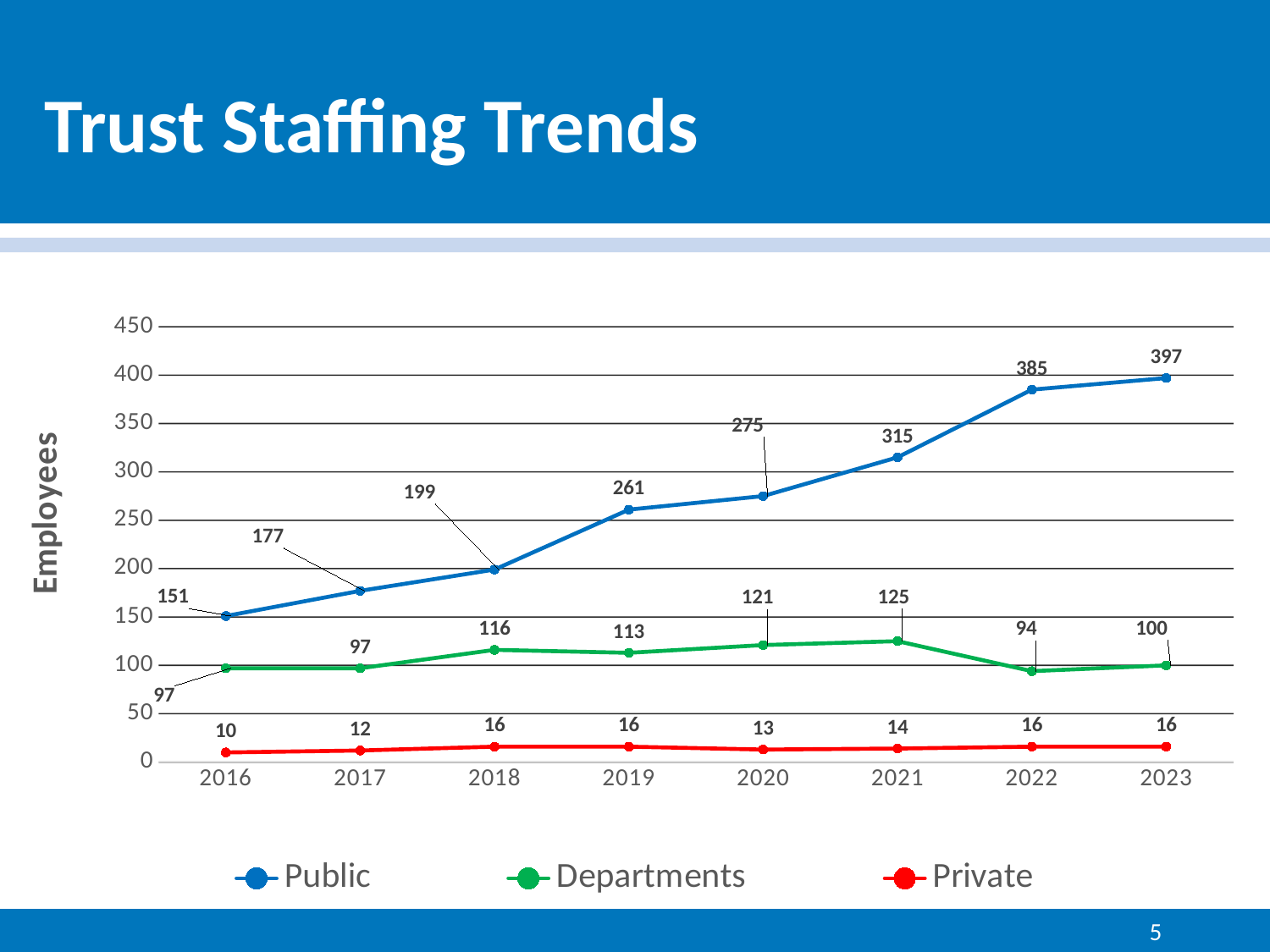
What is the value for Departments in 2021? 125 What kind of chart is shown on the slide? line chart Which is larger, the Departments value in 2018 or in 2019? 2018 What is the difference between the Public values in 2023 and 2016? 246 What is the value for Private in 2017? 12 Does the Public series rise or fall from 2016 to 2023? rise What is the value for Public in 2020? 275 In which year is the Departments series lowest? 2022 How many years are shown on the x axis? 8 In which year is the Public series highest? 2023 How many series does the legend list? 3 Is the value for Public in 2021 greater or less than 300? greater